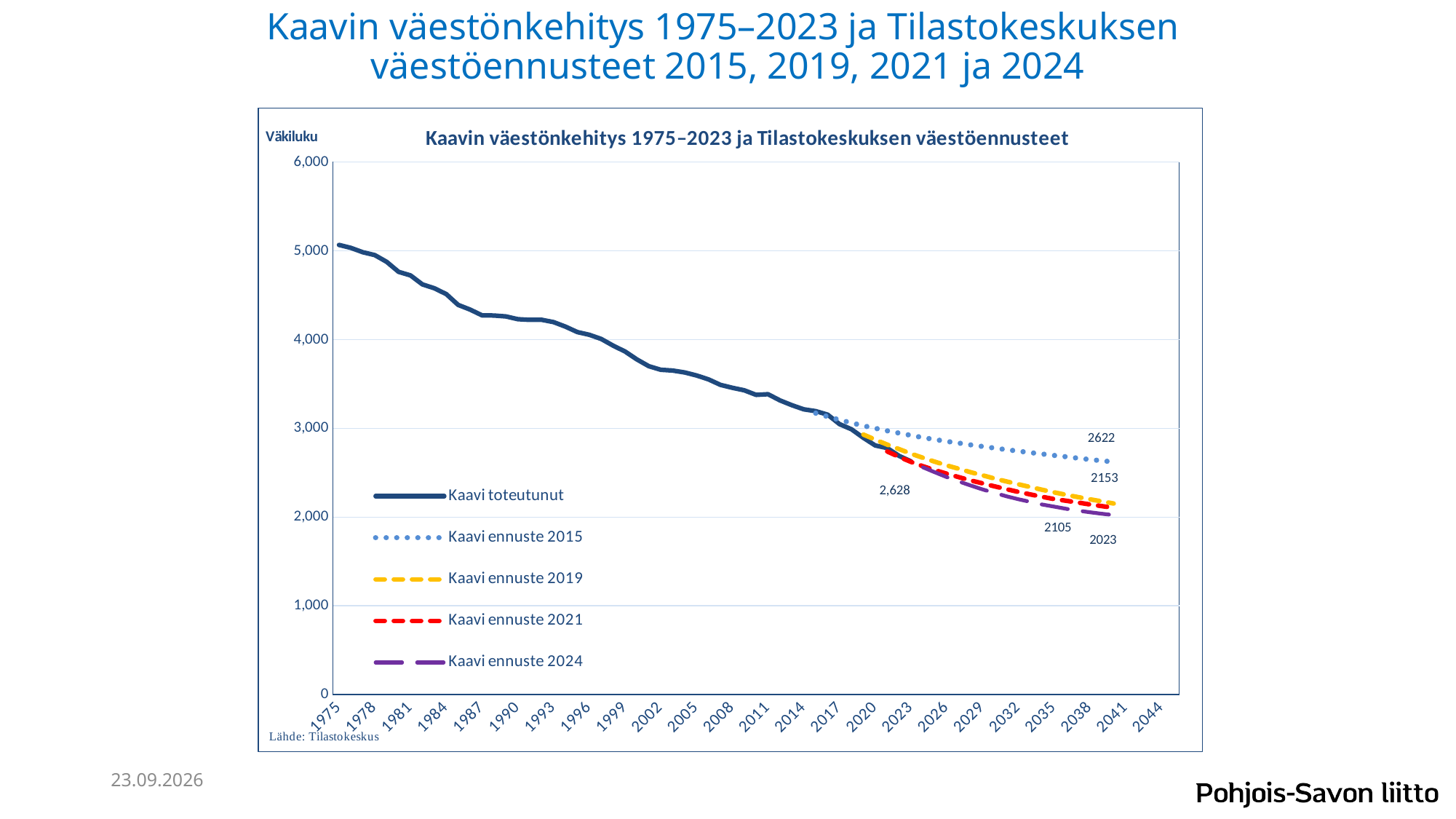
How many series does the legend list? 5 What kind of chart is shown on the slide? line chart What is the final value shown for the Kaavi ennuste 2019 series? 2153 What is the final value shown for the Kaavi ennuste 2015 series? 2622 Is the Kaavi toteutunut value in 1975 greater or less than 5,000? greater Which ends at a higher value, Kaavi ennuste 2019 or Kaavi ennuste 2021? Kaavi ennuste 2019 Does the Kaavi toteutunut series rise or fall from 1975 to 2023? fall What is the last labelled value of the Kaavi toteutunut series? 2,628 Which forecast series ends at the highest value? Kaavi ennuste 2015 What is the final value shown for the Kaavi ennuste 2024 series? 2023 What is the difference between the final values of Kaavi ennuste 2015 (2622) and Kaavi ennuste 2024 (2023)? 599 Which forecast series ends at the lowest value? Kaavi ennuste 2024